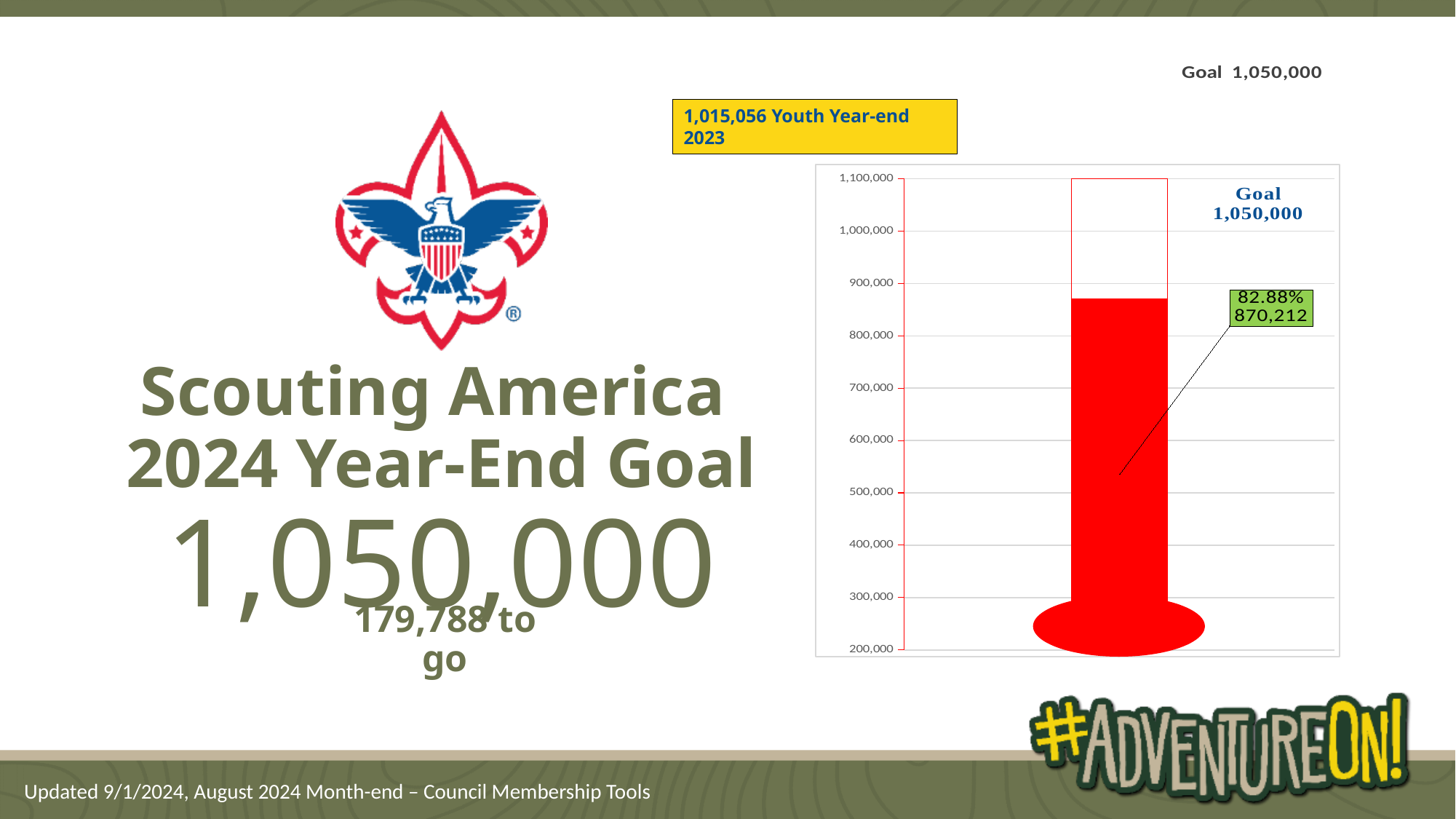
What is the highest tick value shown on the vertical axis of the thermometer chart? 1,100,000 What colour is the filled bar in the thermometer chart? red Which is larger on the chart: the current value of 870,212 or the goal of 1,050,000? the goal of 1,050,000 What kind of chart is used to show progress toward the goal? bar chart (thermometer style) Is the value of the red bar in the thermometer chart greater or less than 900,000? less What percentage of the goal does the thermometer chart's data label show has been reached? 82.88% How many bars are plotted in the thermometer chart? 1 What is the lowest tick value shown on the vertical axis of the thermometer chart? 200,000 Is the value of the red bar in the thermometer chart greater or less than 800,000? greater How far below the goal of 1,050,000 is the current value of 870,212 shown on the chart? 179,788 What goal value is printed on the thermometer chart? 1,050,000 What value does the data label on the thermometer chart show for the current membership? 870,212